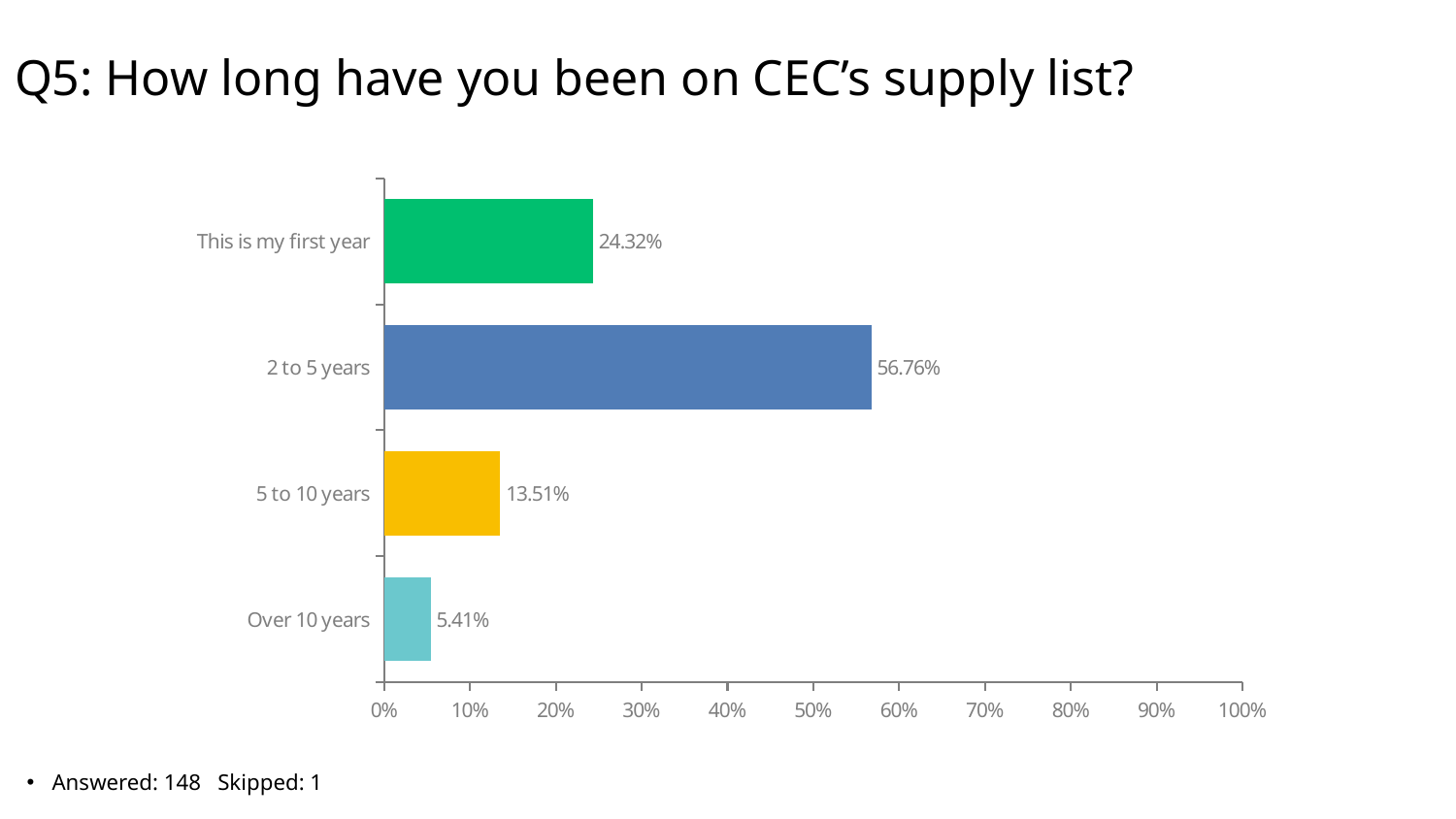
What is the value for the '5 to 10 years' category? 13.51% What percentage of respondents said this is their first year on CEC's supply list? 24.32% Which is larger, the value for '5 to 10 years' or the value for 'Over 10 years'? 5 to 10 years Is the value for '2 to 5 years' greater or less than 50%? greater What is the title of the slide containing the chart? Q5: How long have you been on CEC's supply list? What is the value for the 'Over 10 years' category? 5.41% What is the value for the '2 to 5 years' category? 56.76% What is the difference between the '2 to 5 years' value and the 'This is my first year' value? 32.44% Which category has the highest value? 2 to 5 years How many categories are shown in the chart? 4 Which category has the lowest value? Over 10 years What kind of chart is shown on the slide? bar chart